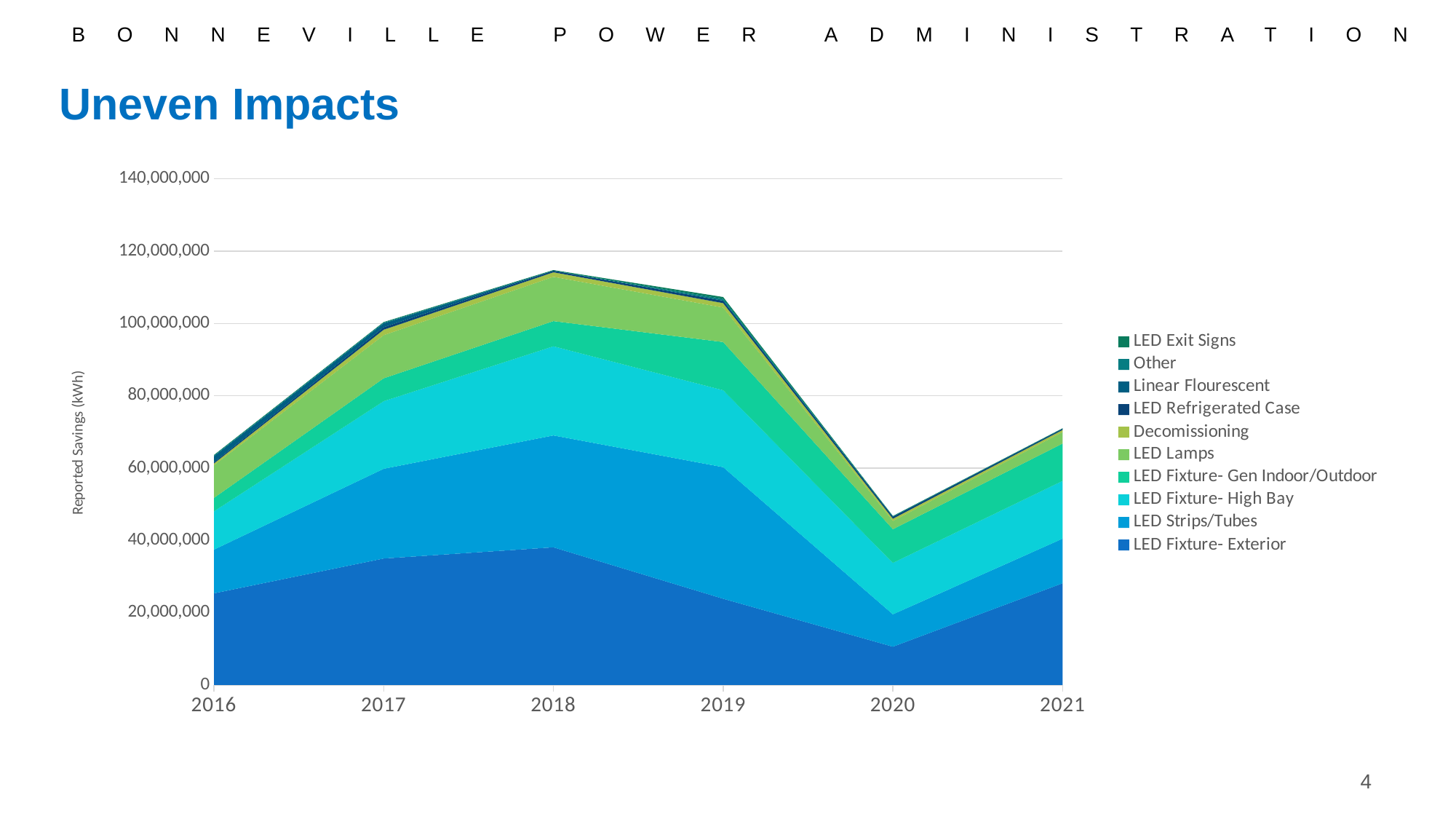
What is the label on the vertical axis? Reported Savings (kWh) What kind of chart is shown on the slide? stacked area chart Is the total reported savings in 2018 greater or less than 100,000,000? greater Which year has the larger total reported savings, 2017 or 2021? 2017 In which year is the total reported savings highest? 2018 Do total reported savings rise or fall from 2018 to 2020? fall Is the value for LED Fixture- Exterior in 2020 greater or less than 20,000,000? less In which year is the total reported savings lowest? 2020 How many years are plotted along the x axis? 6 Is the value for LED Fixture- Exterior in 2016 greater or less than 20,000,000? greater How many series does the legend list? 10